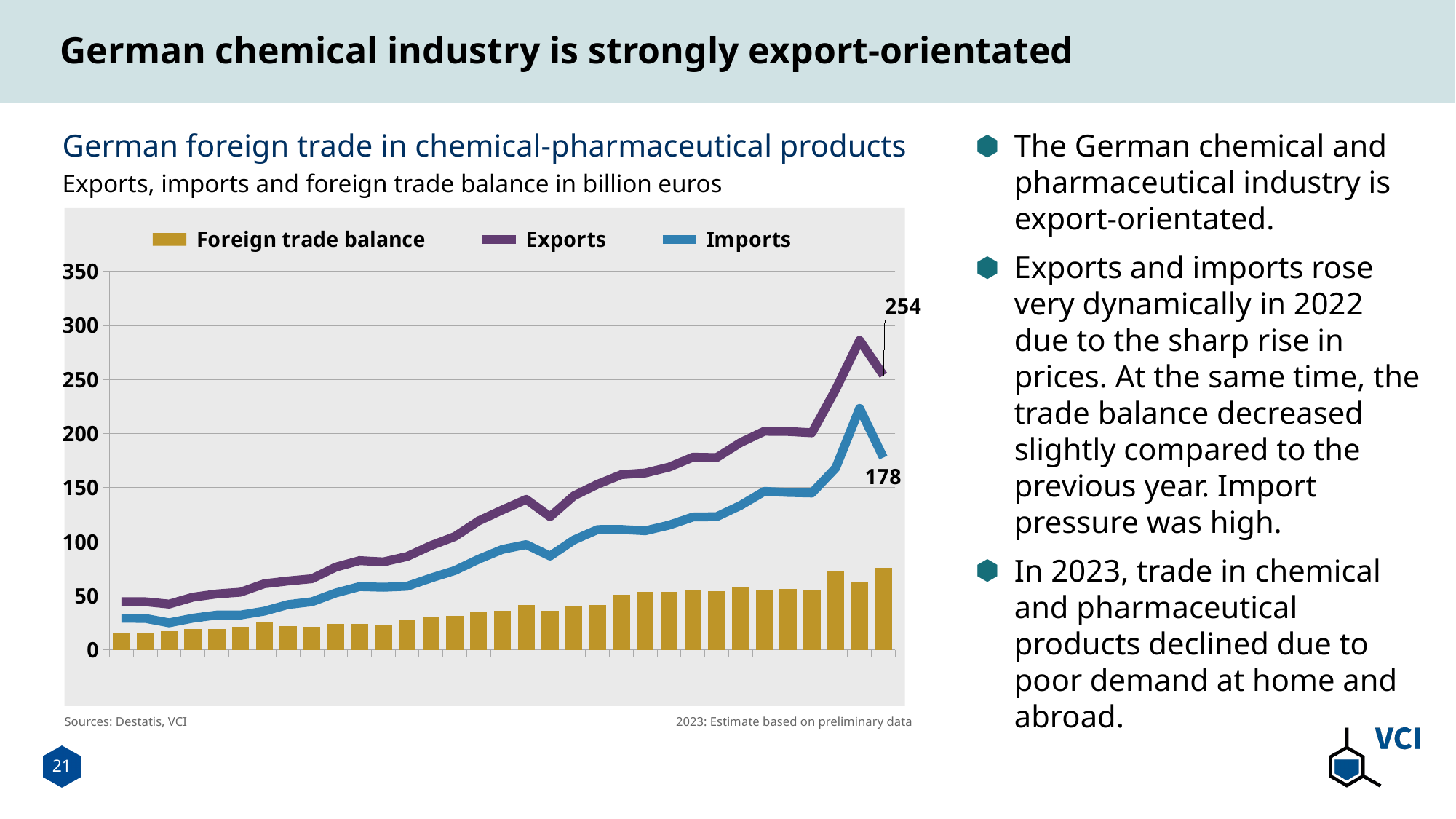
What is the value of Imports at the final data point on the right of the chart? 178 Is the peak value of the Exports line greater or less than 250? greater Do the Exports values generally rise or fall from left to right along the x axis? rise What kind of chart is shown on the slide? A combined bar and line chart How many series does the chart legend list? 3 At the final data point, which is larger, Exports or Imports? Exports What are the three series named in the chart legend? Foreign trade balance, Exports, Imports Which series has the highest value at the final data point? Exports What is the value of Exports at the final data point on the right of the chart? 254 What is the title of the chart? German foreign trade in chemical-pharmaceutical products Is the peak value of the Imports line greater or less than 200? greater What is the difference between the final Exports value (254) and the final Imports value (178)? 76